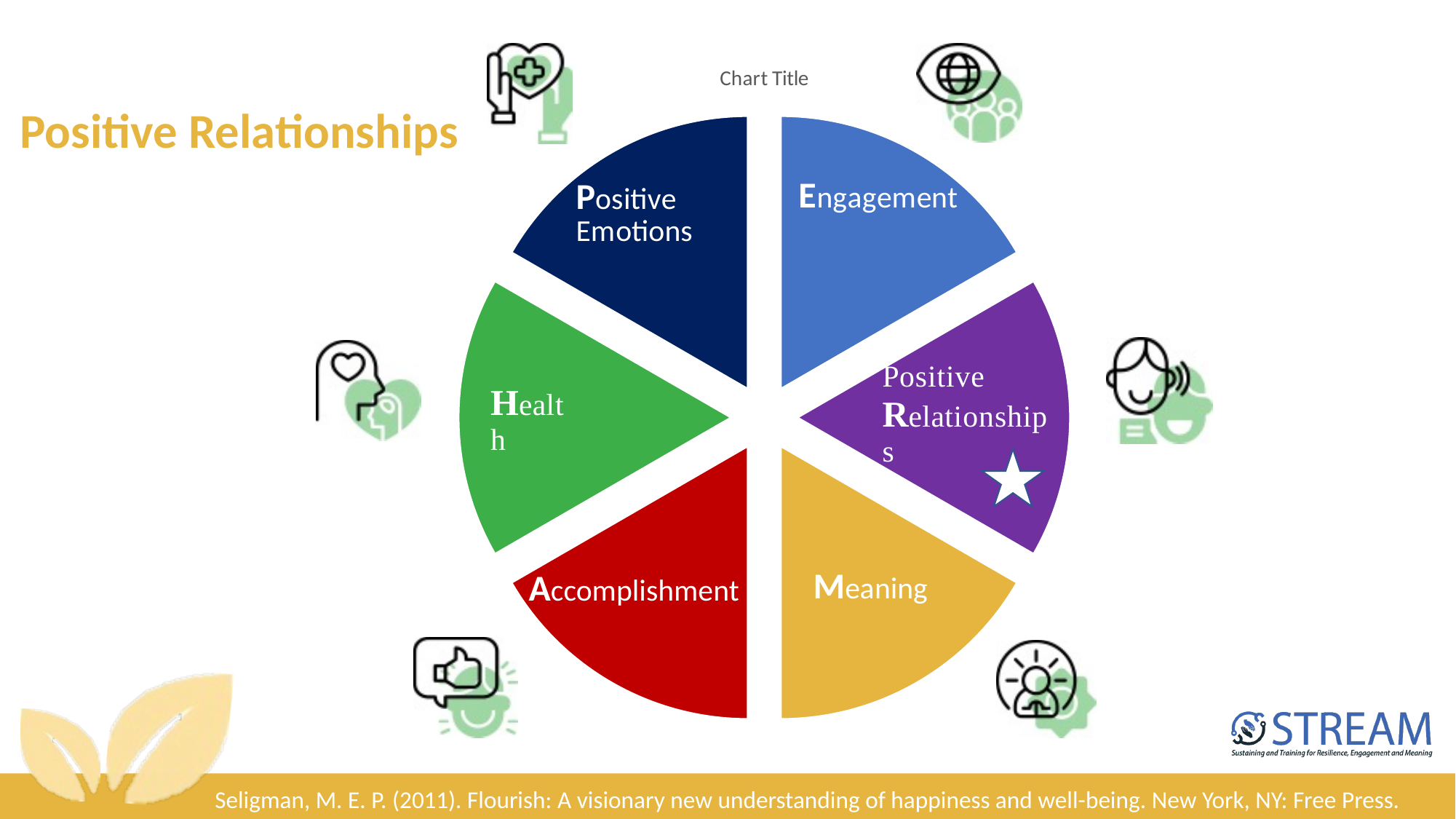
Which slice of the pie chart is coloured red? Accomplishment Which slice of the pie chart is coloured yellow? Meaning Which slice of the pie chart contains a white star? Positive Relationships What kind of chart is shown on the slide? pie chart What is the title printed above the pie chart? Chart Title How many slices does the pie chart have? 6